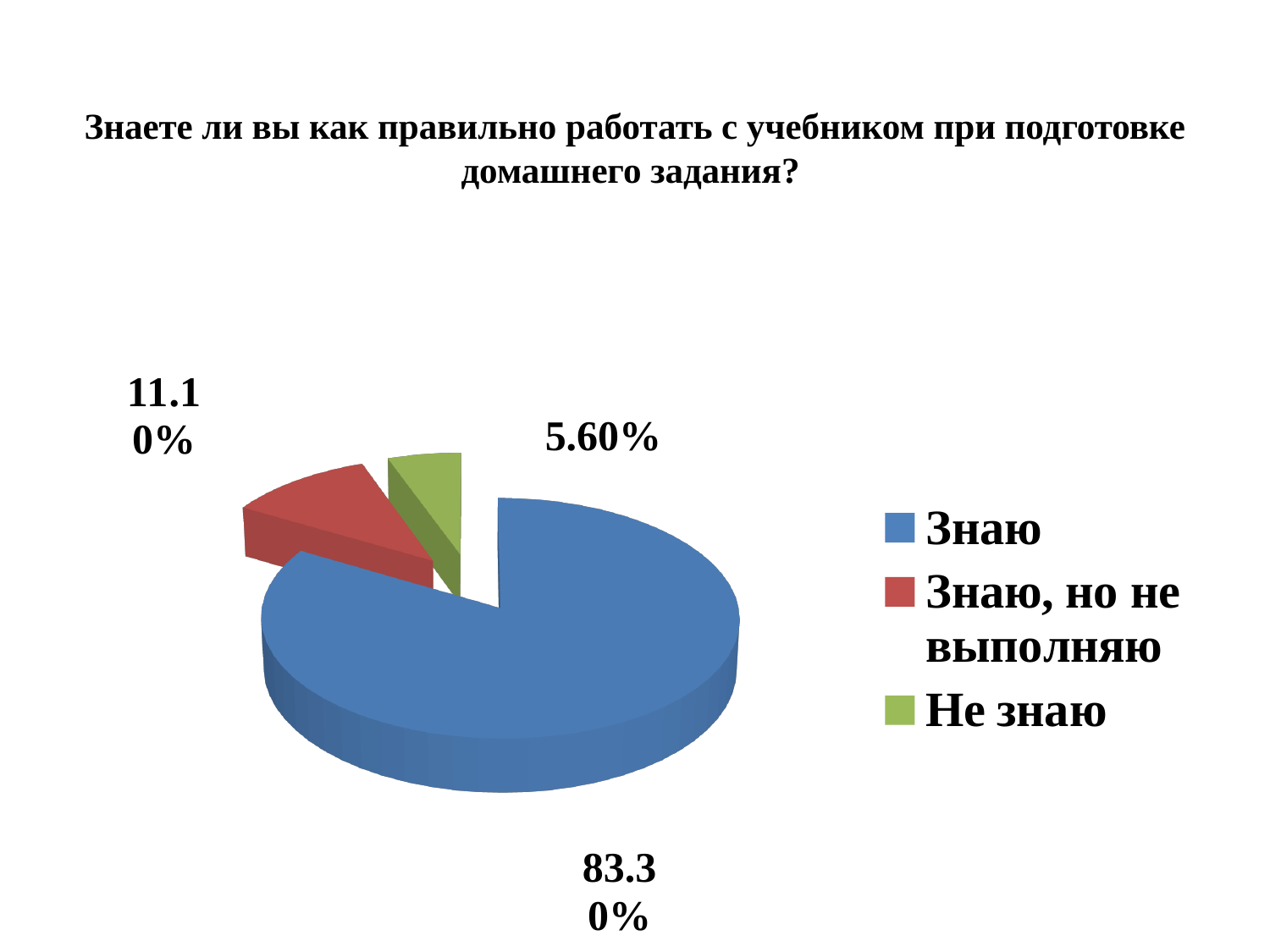
What share of the pie does "Знаю, но не выполняю" have? 11.10% Which category has the largest slice of the pie? Знаю What share of the pie does "Не знаю" have? 5.60% What share of the pie does "Знаю" have? 83.30% What kind of chart is shown on the slide? pie chart How many categories does the pie chart have? 3 Which is larger: the share for "Знаю, но не выполняю" or the share for "Не знаю"? Знаю, но не выполняю Which colour represents "Не знаю" in the legend? green What is the difference between the shares of "Знаю" and "Знаю, но не выполняю"? 72.20% What is the difference between the shares of "Знаю, но не выполняю" and "Не знаю"? 5.50% Which category has the smallest slice of the pie? Не знаю What is the title of the chart? Знаете ли вы как правильно работать с учебником при подготовке домашнего задания?